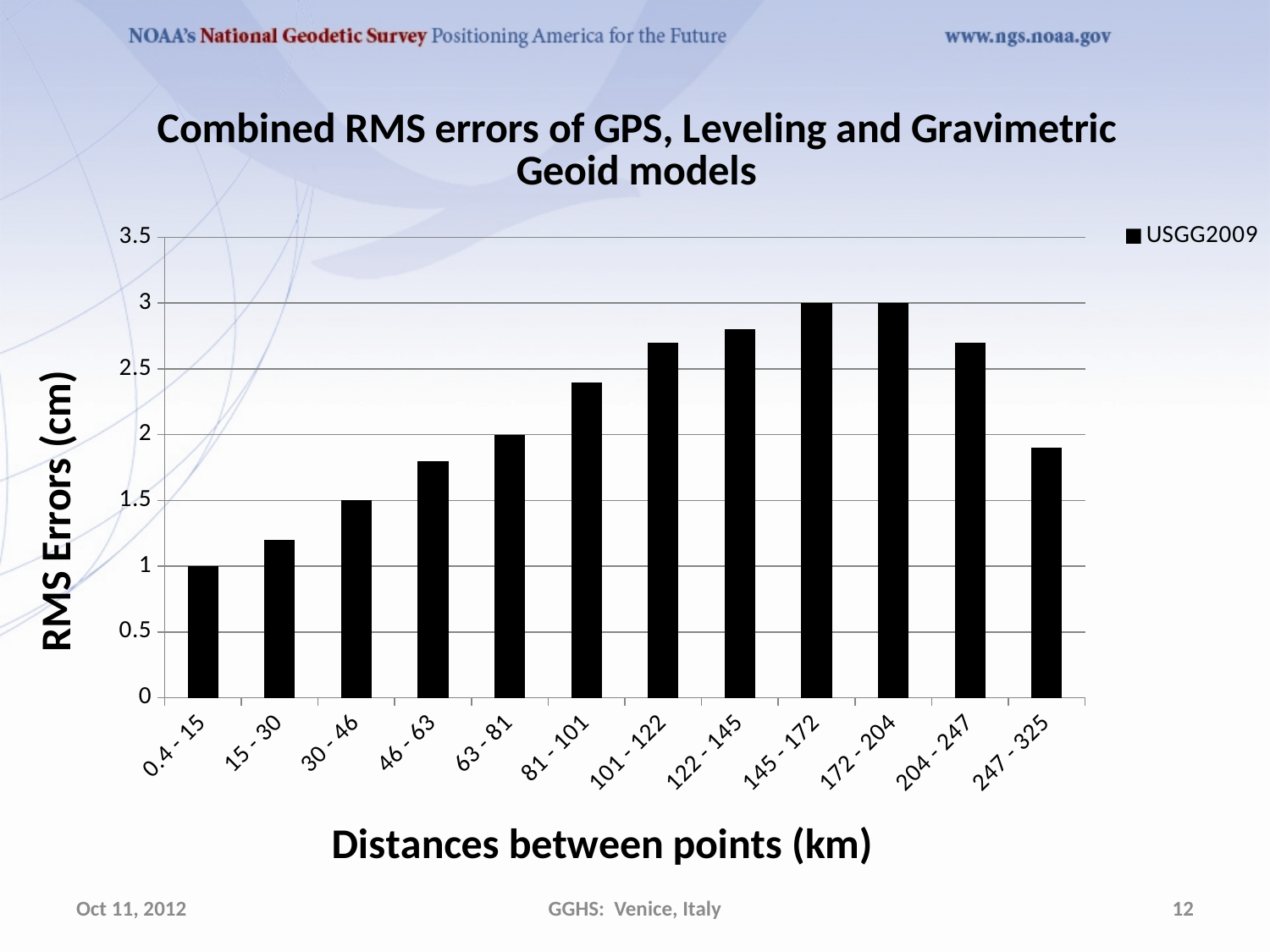
Is the RMS error for the 247 - 325 km category greater or less than 2? less How many series does the legend list? 1 Which has the larger RMS error, the 122 - 145 km category or the 247 - 325 km category? 122 - 145 How many distance categories are shown on the x axis? 12 What is the RMS error for the 0.4 - 15 km distance category? 1 What is the RMS error for the 145 - 172 km distance category? 3 Which distance category has the lowest RMS error? 0.4 - 15 What is the name of the series shown in the legend? USGG2009 What is the RMS error for the 63 - 81 km distance category? 2 What kind of chart is shown on the slide? bar chart Is the RMS error for the 81 - 101 km category greater or less than 2? greater What is the RMS error for the 30 - 46 km distance category? 1.5